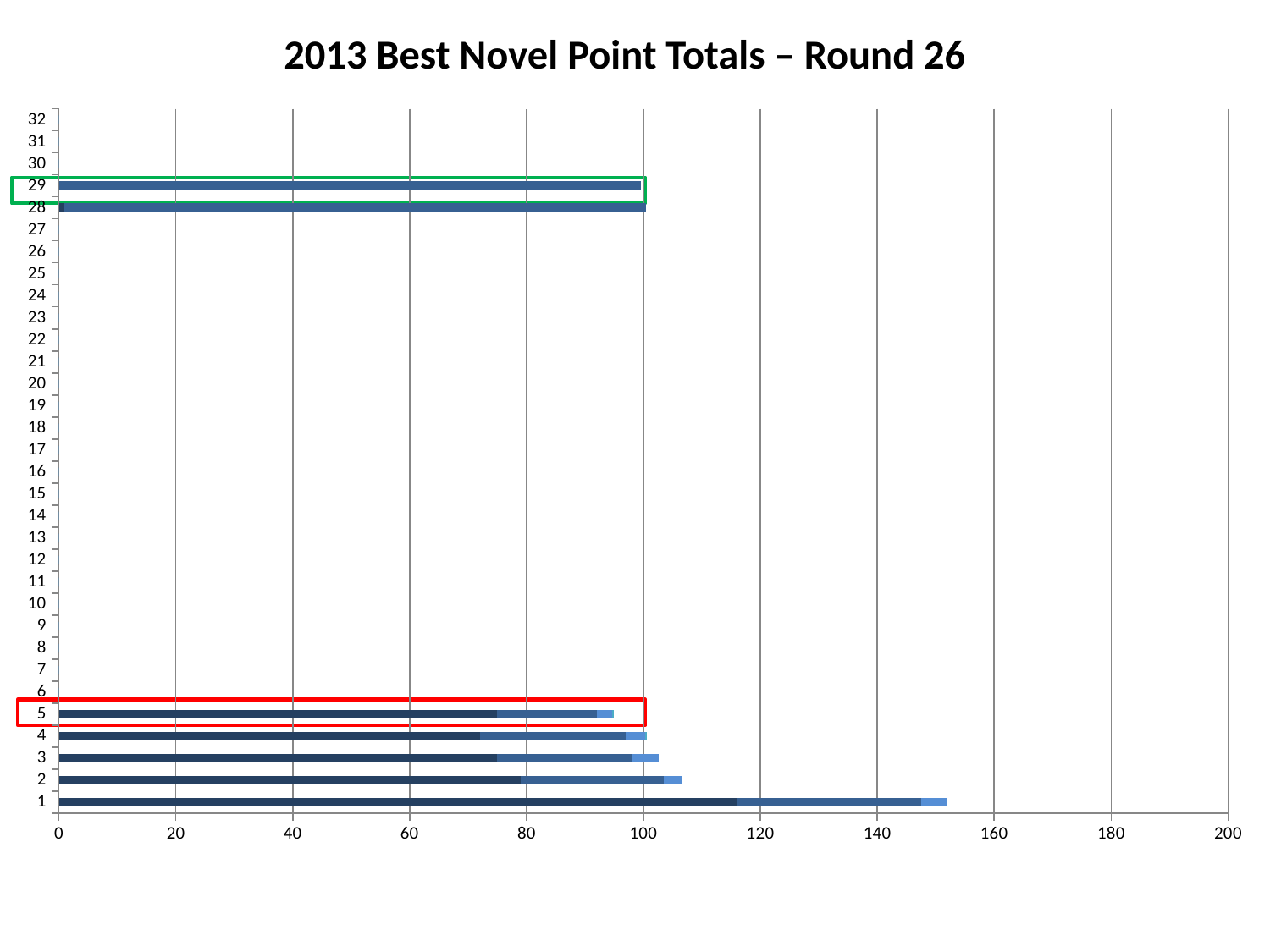
How many categories are listed on the vertical axis? 32 Which has the larger total, category 1 or category 2? 1 Is the total value for category 5 greater or less than 100? less Which category has the longest bar? 1 Is the value for category 29 greater or less than 120? less What kind of chart is shown on the slide? bar chart Is the total value for category 4 greater or less than 80? greater What is the title of the chart? 2013 Best Novel Point Totals – Round 26 Which category is outlined with a red box? 5 Which has the larger total, category 2 or category 5? 2